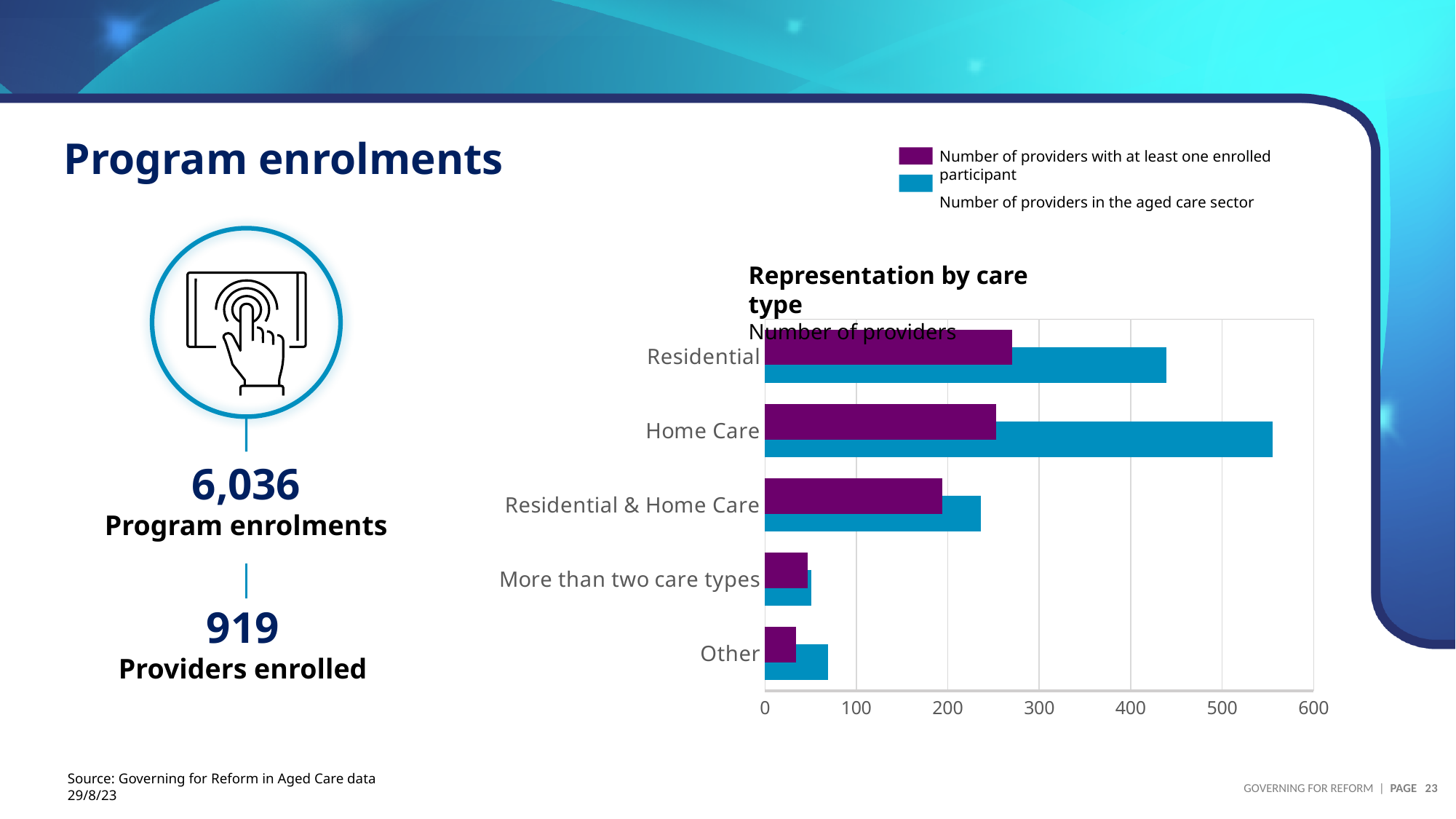
What kind of chart is shown on the slide? bar chart Is the number of providers in the aged care sector for Home Care greater or less than 500? greater What is the title of the chart? Representation by care type Is the number of providers in the aged care sector for Other greater or less than 100? less Is the number of providers in the aged care sector for Residential greater or less than 400? greater Which care type has the highest number of providers in the aged care sector? Home Care How many care type categories are shown on the chart? 5 For Residential & Home Care, which is larger: the number of providers in the aged care sector or the number of providers with at least one enrolled participant? Number of providers in the aged care sector Which care type has the lowest number of providers in the aged care sector? Other How many series does the chart legend list? 2 Which is larger: the number of providers in the aged care sector for Home Care or for Residential? Home Care